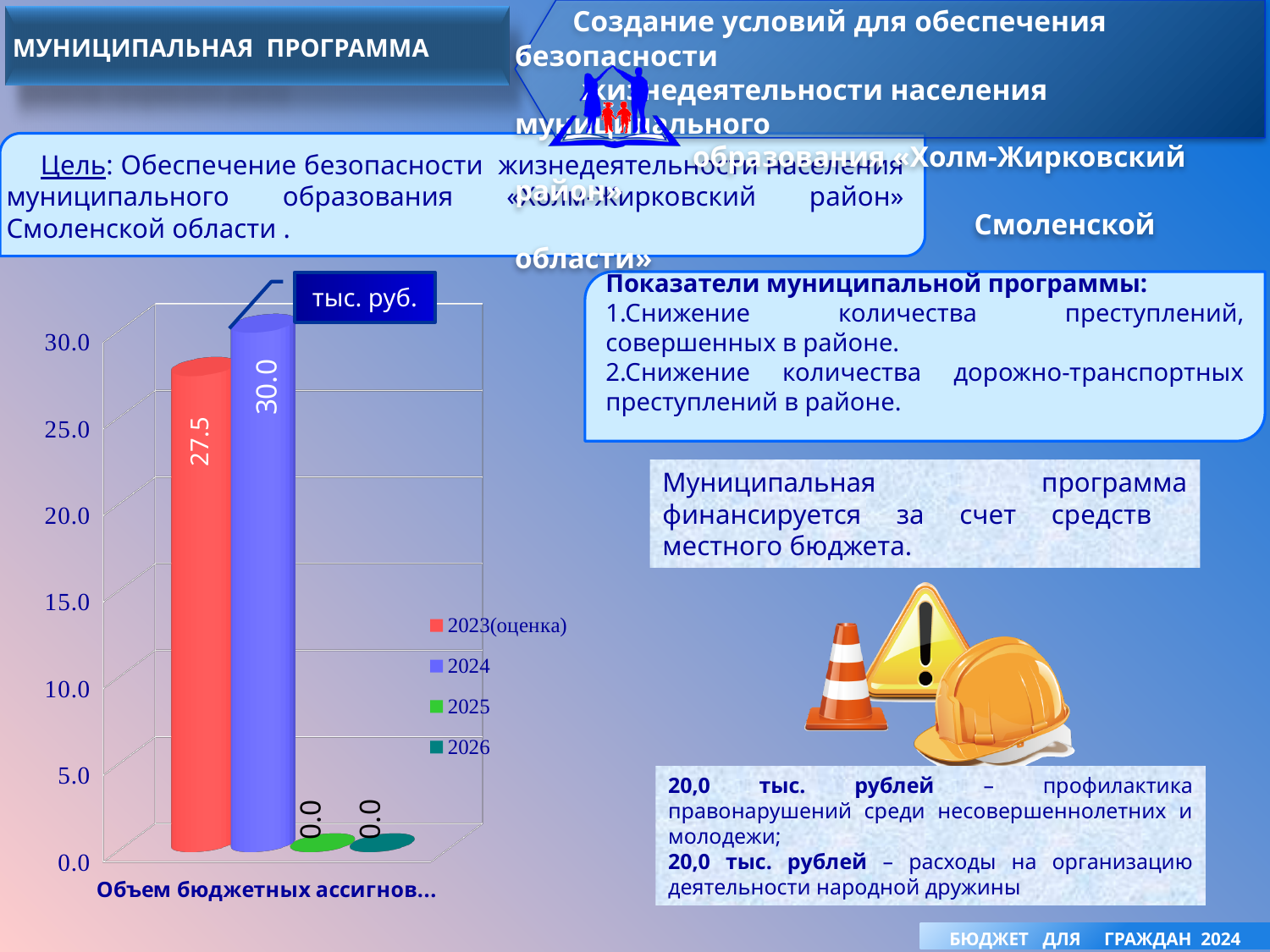
How many series does the chart legend list? 4 Is the value for 2023(оценка) greater or less than 25.0? greater What is the difference between the values for 2024 and 2023(оценка)? 2.5 What is the value for 2026 on the chart? 0.0 What unit is shown in the label box above the chart? тыс. руб. Which is larger, the value for 2023(оценка) or the value for 2024? 2024 What kind of chart is shown on the slide? bar chart What colour is the bar for 2024 in the chart? blue What is the value for 2023(оценка) on the chart? 27.5 Which year has the highest value on the chart? 2024 What is the value for 2025 on the chart? 0.0 What is the value for 2024 on the chart? 30.0